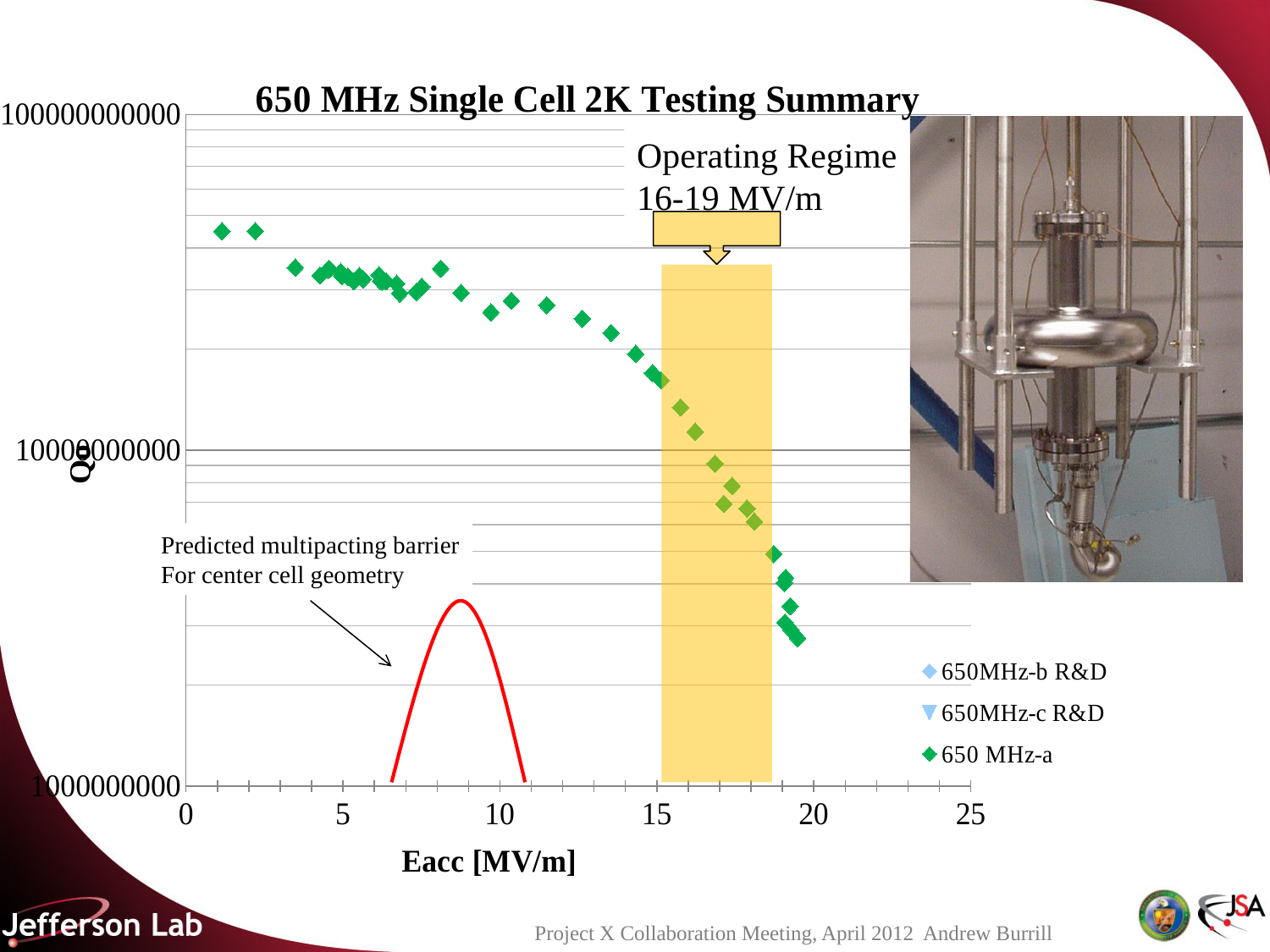
What is the highest value shown on the x axis of the chart? 25 What kind of chart is shown on the slide? scatter chart How many series does the chart's legend list? 3 What is the label of the x axis of the chart? Eacc [MV/m] Are the Q0 values plotted near Eacc = 2 MV/m greater or less than 10000000000? greater Which is larger, the Q0 value plotted at about Eacc = 5 MV/m or the one at about Eacc = 19 MV/m? the one at about 5 MV/m Do the plotted Q0 values rise or fall as Eacc increases along the x axis? fall What is the title of the chart? 650 MHz Single Cell 2K Testing Summary Are the Q0 values plotted near Eacc = 19 MV/m greater or less than 10000000000? less